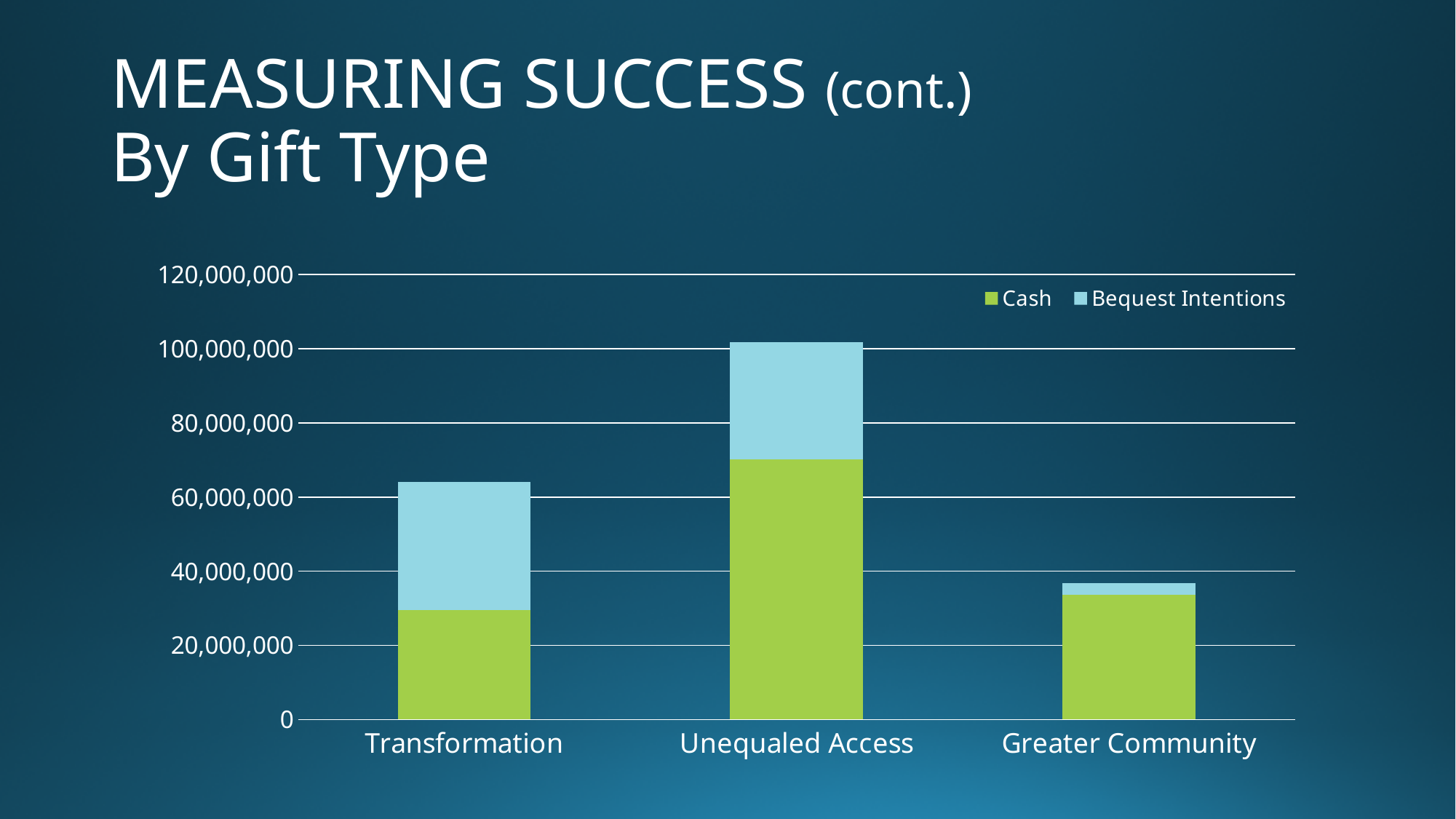
Is the Cash value for Transformation greater or less than 40,000,000? less Which category has the smallest Bequest Intentions value? Greater Community How many series does the legend list? 2 How many gift-type categories are shown on the x axis? 3 Which category has the largest Cash value? Unequaled Access Which category has the lowest total bar? Greater Community Which is larger: the Bequest Intentions value for Transformation or for Greater Community? Transformation Is the total bar for Greater Community greater or less than 40,000,000? less Which colour represents the Cash series in the legend? Green Is the Cash value for Unequaled Access greater or less than 60,000,000? greater Which category has the highest total bar? Unequaled Access What kind of chart is shown on the slide? Stacked bar chart